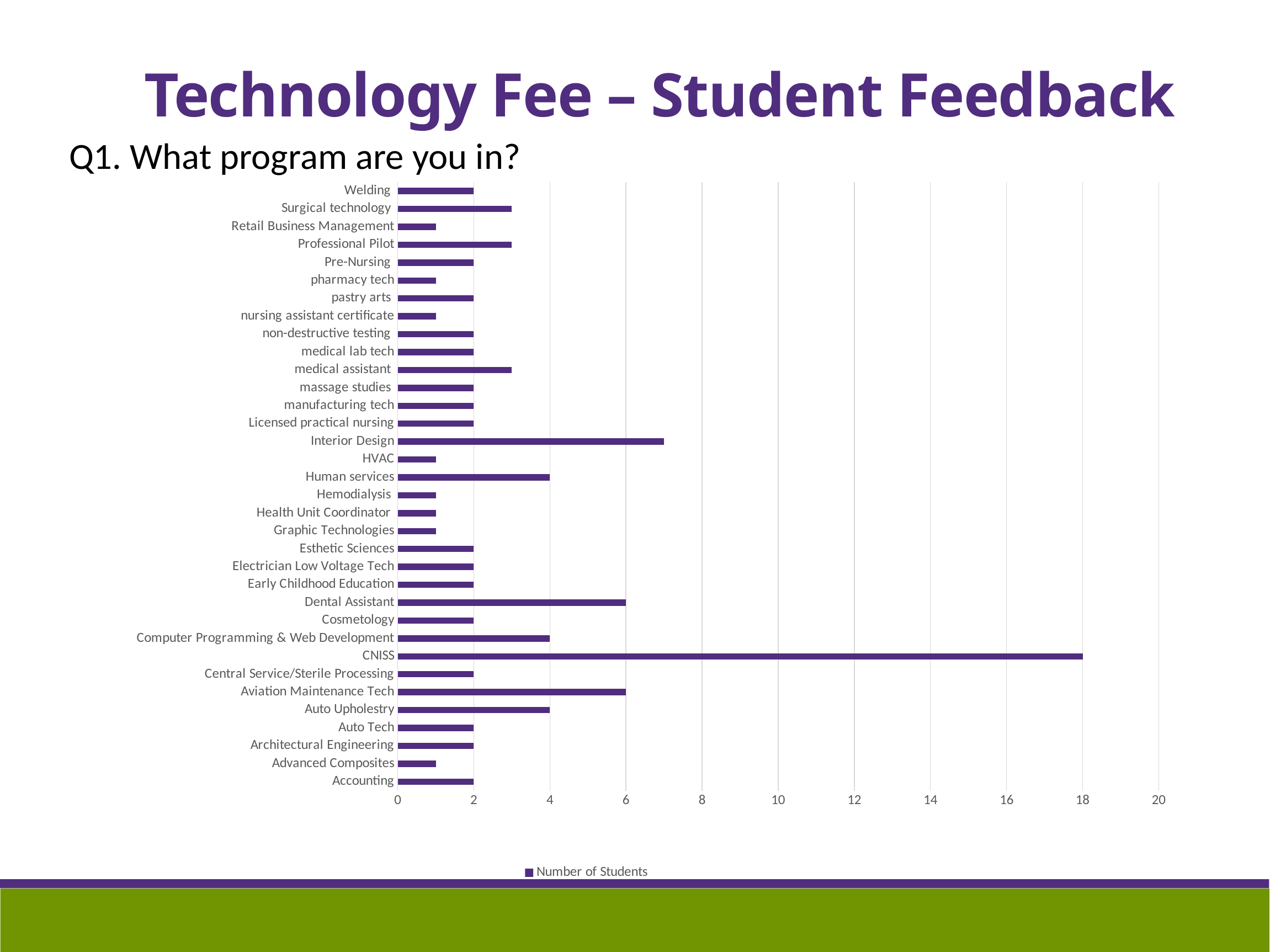
What is the legend entry shown below the chart? Number of Students What is the number of students for Dental Assistant? 6 Is the value for Interior Design greater or less than 6? greater What is the number of students for CNISS? 18 What is the difference between the number of students for CNISS and for Aviation Maintenance Tech? 12 How many programs are listed on the chart? 34 How many series does the legend list? 1 Which has more students, Interior Design or Dental Assistant? Interior Design What is the number of students for Human services? 4 Is the value for HVAC greater or less than 2? less What kind of chart is shown on the slide? bar chart Which program has the highest number of students? CNISS